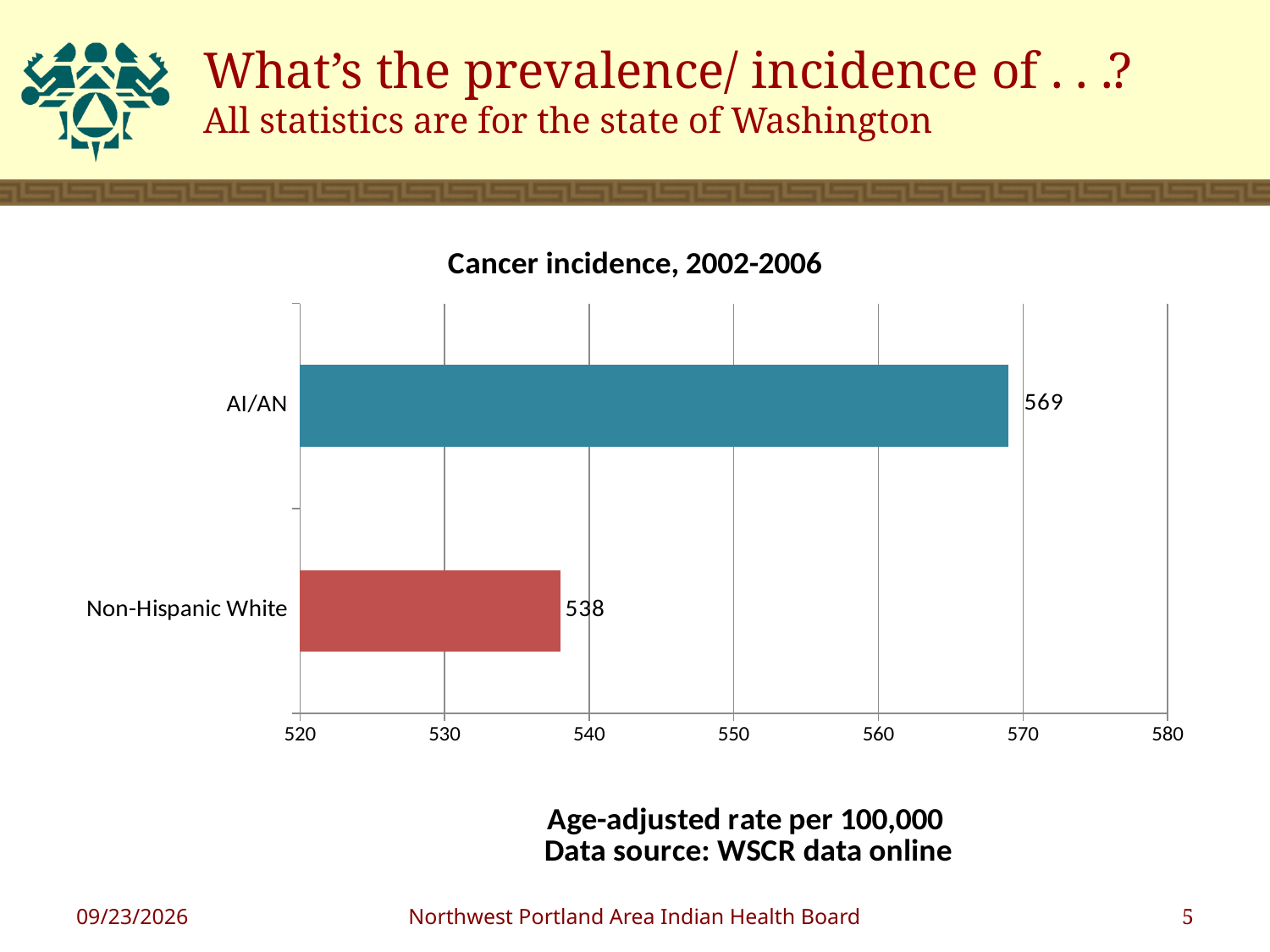
What is the difference between the AI/AN and Non-Hispanic White cancer incidence values? 31 Is the value for AI/AN greater or less than 560? greater Which category has the highest cancer incidence? AI/AN Which category has the lowest cancer incidence? Non-Hispanic White What is the cancer incidence value for AI/AN? 569 What is the highest value shown on the x axis? 580 What kind of chart is shown on the slide? bar chart Which is larger, the value for AI/AN or the value for Non-Hispanic White? AI/AN How many categories are shown in the chart? 2 What is the title of the chart? Cancer incidence, 2002-2006 Is the value for Non-Hispanic White greater or less than 540? less What is the cancer incidence value for Non-Hispanic White? 538